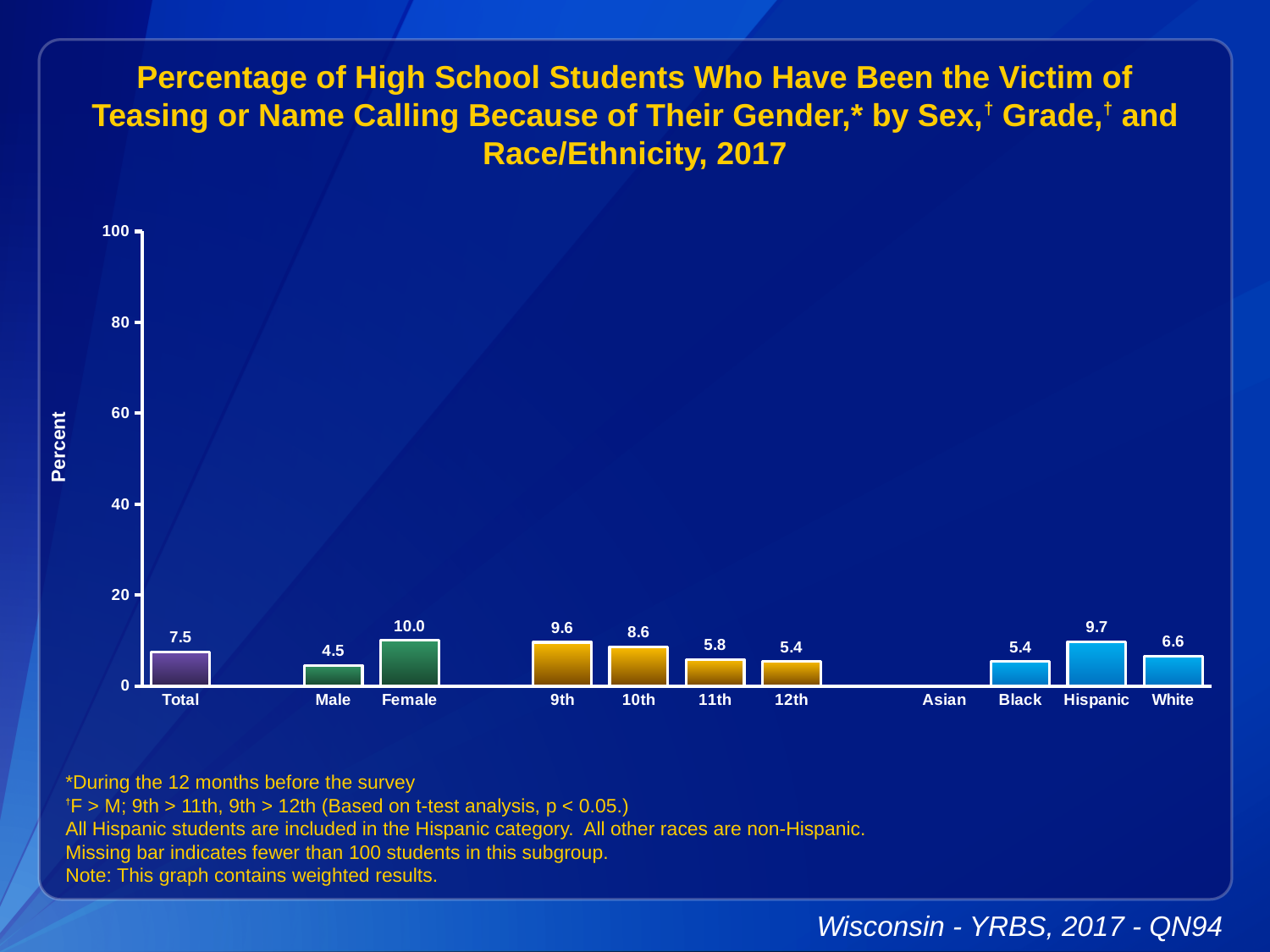
Which category has the highest value on the chart? Female Which is larger, the value for 10th grade or the value for 11th grade? 10th What is the value for Female? 10.0 What is the difference between the Female and Male values? 5.5 What is the value for Hispanic? 9.7 How many bars are plotted on the chart? 10 Which race/ethnicity category has no bar shown? Asian What is the value for 9th grade? 9.6 Is the value for White greater or less than 20? less What kind of chart is shown? bar chart Which grade has the lowest value? 12th What is the value for Total? 7.5